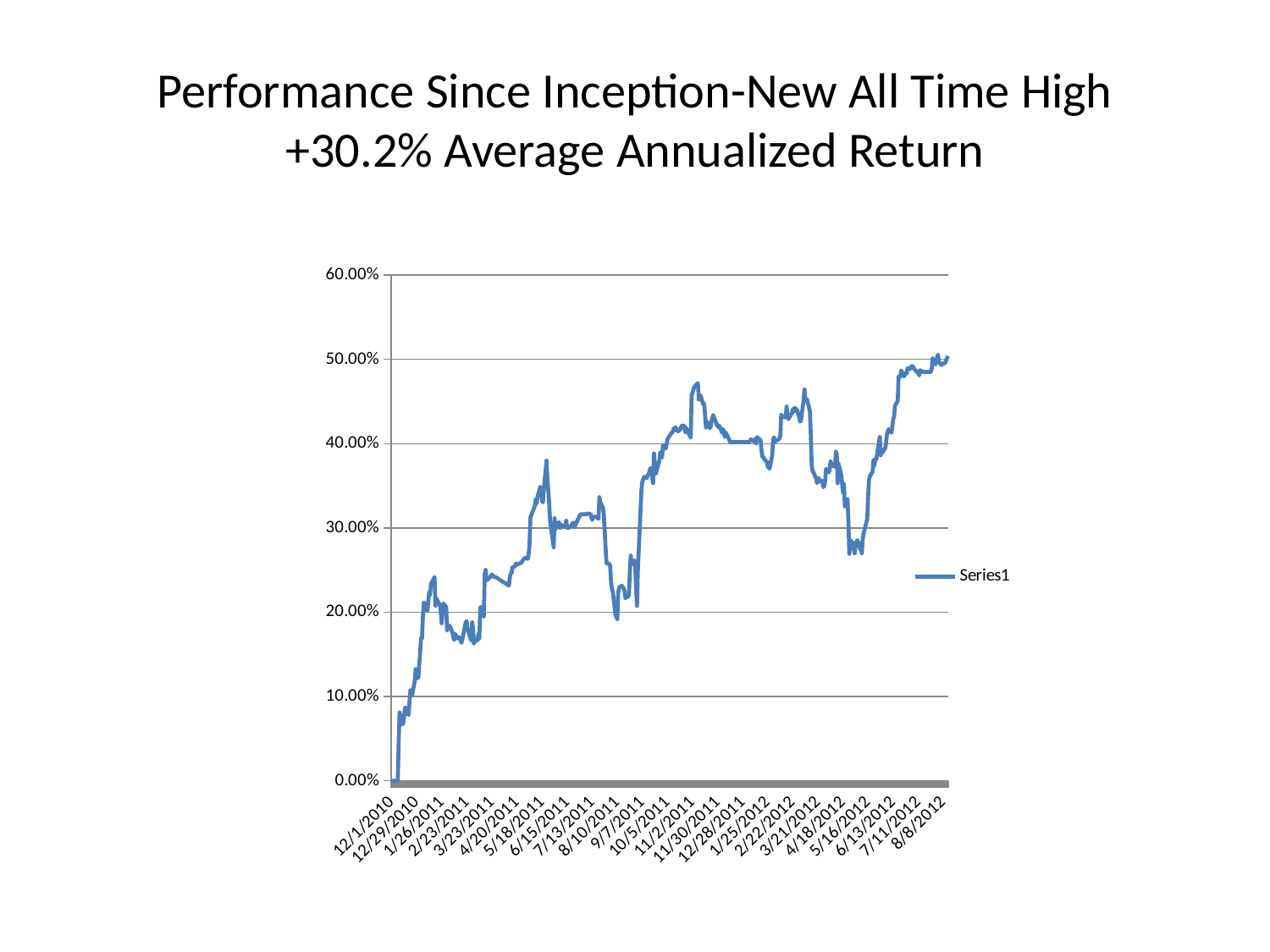
Is the value at 12/1/2010 greater or less than 10.00%? less What is the name of the series shown in the legend? Series1 Overall, do the values rise or fall from 12/1/2010 to 8/8/2012? rise Is the value at 8/8/2012 greater or less than 40.00%? greater Which is larger, the value at 8/8/2012 or the value at 5/16/2012? 8/8/2012 Is the value around 2/23/2011 greater or less than 20.00%? less How many series does the legend list? 1 What is the highest value shown on the y axis? 60.00% What kind of chart is shown on the slide? line chart What is the title of the slide containing the chart? Performance Since Inception-New All Time High +30.2% Average Annualized Return